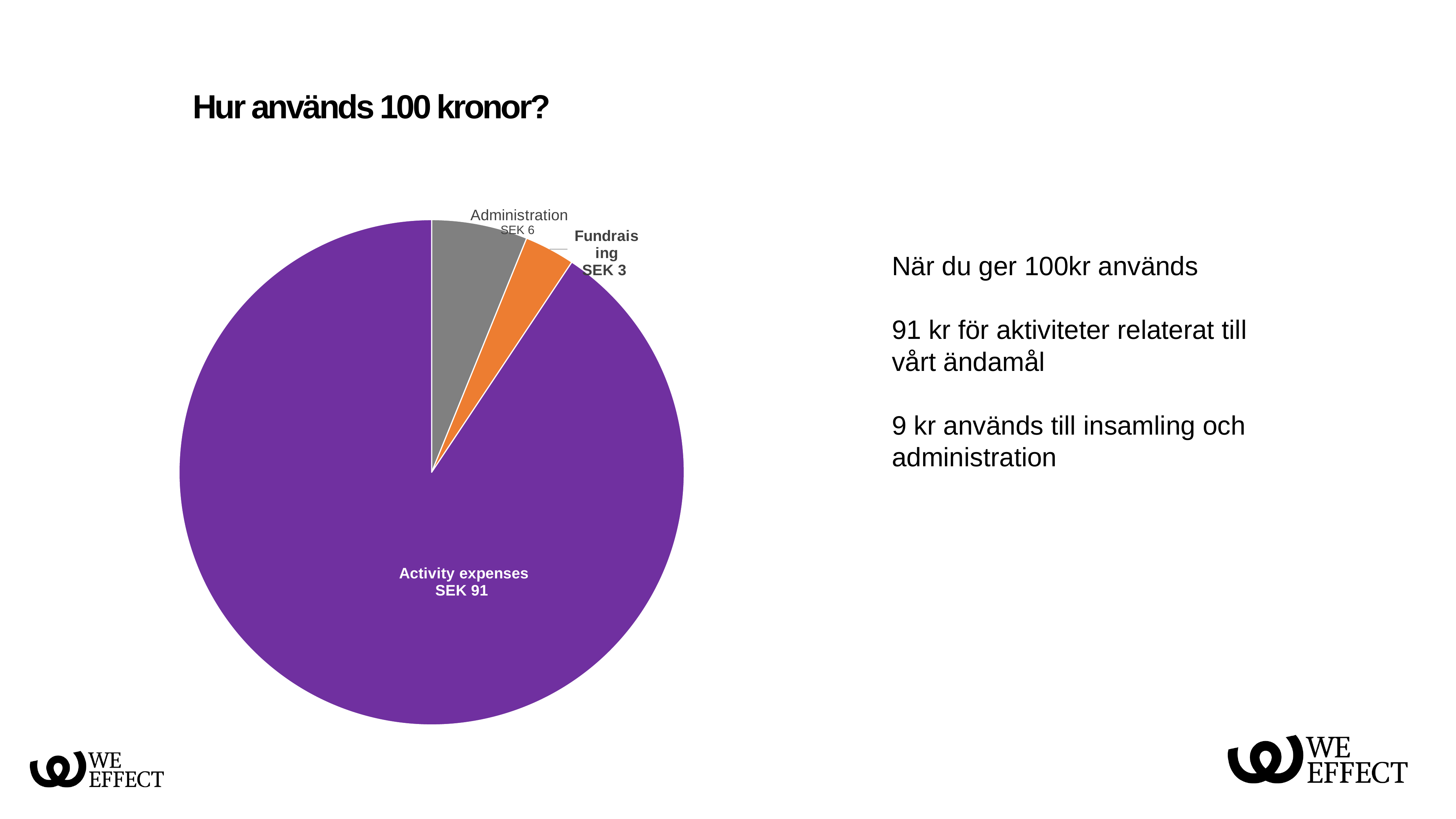
How many slices does the pie chart have? 3 Which category has the largest slice? Activity expenses What kind of chart is shown on the slide? Pie chart Which is larger, Administration or Fundraising? Administration What is the value for Fundraising? SEK 3 What colour is the Activity expenses slice? Purple What is the value for Activity expenses? SEK 91 What is the difference between Activity expenses and Administration? SEK 85 What is the value for Administration? SEK 6 Which category has the smallest slice? Fundraising What is the difference between Administration and Fundraising? SEK 3 What share of the pie does Activity expenses represent? 91%